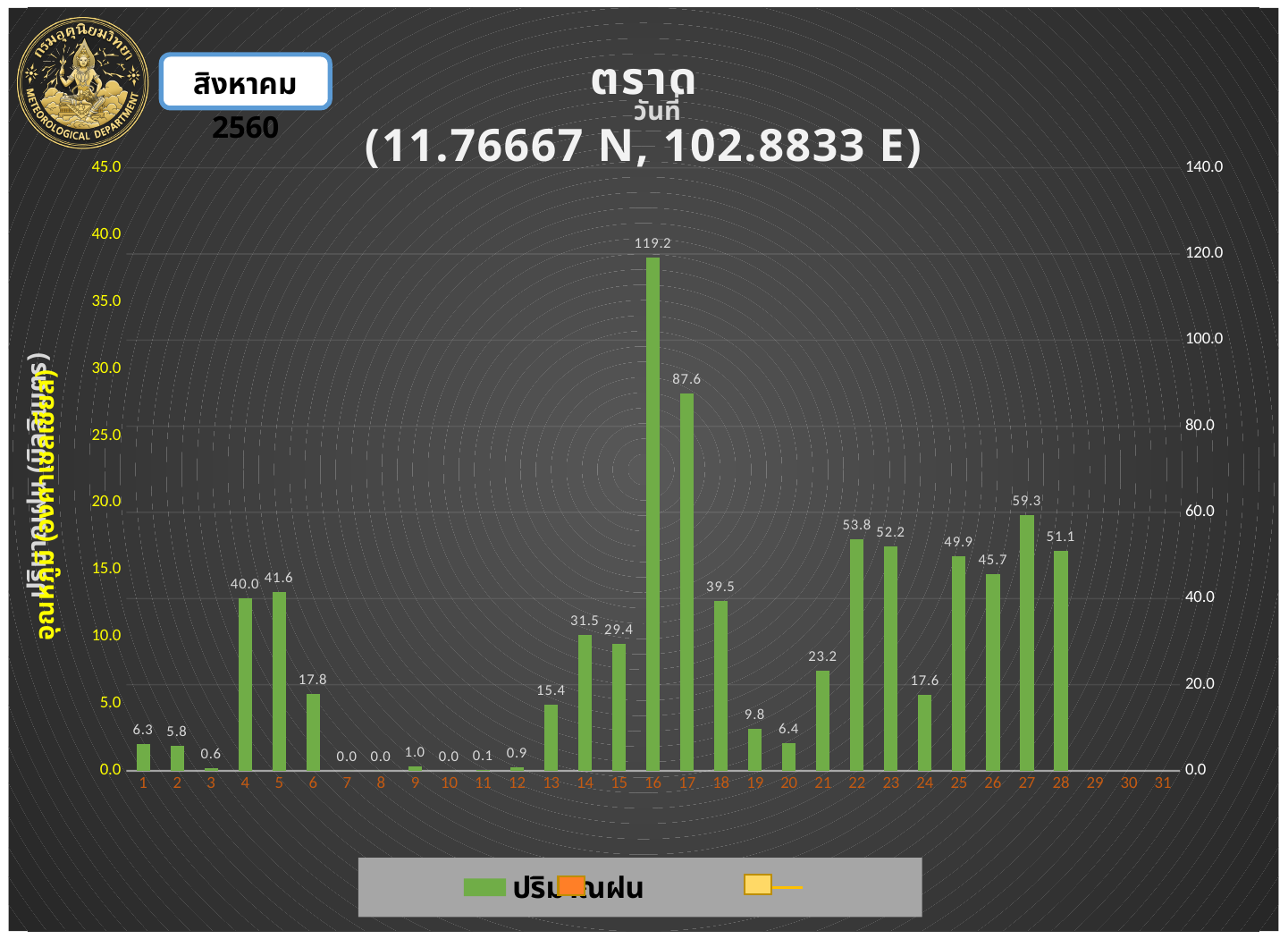
Which is larger, the rainfall value for day 25 or for day 26? day 25 Which is larger, the rainfall value for day 14 or for day 15? day 14 Which day has the highest rainfall bar? 16 What colour are the rainfall (ปริมาณฝน) bars? green How many days are shown on the x axis? 31 What kind of chart is shown on the slide? bar chart What is the difference between the rainfall values for day 16 and day 17? 31.6 What is the rainfall value shown for day 5? 41.6 Is the rainfall value for day 17 greater or less than 80.0 on the right axis? greater What is the rainfall value shown for day 16? 119.2 What is the rainfall value shown for day 27? 59.3 What is the difference between the rainfall values for day 22 and day 23? 1.6